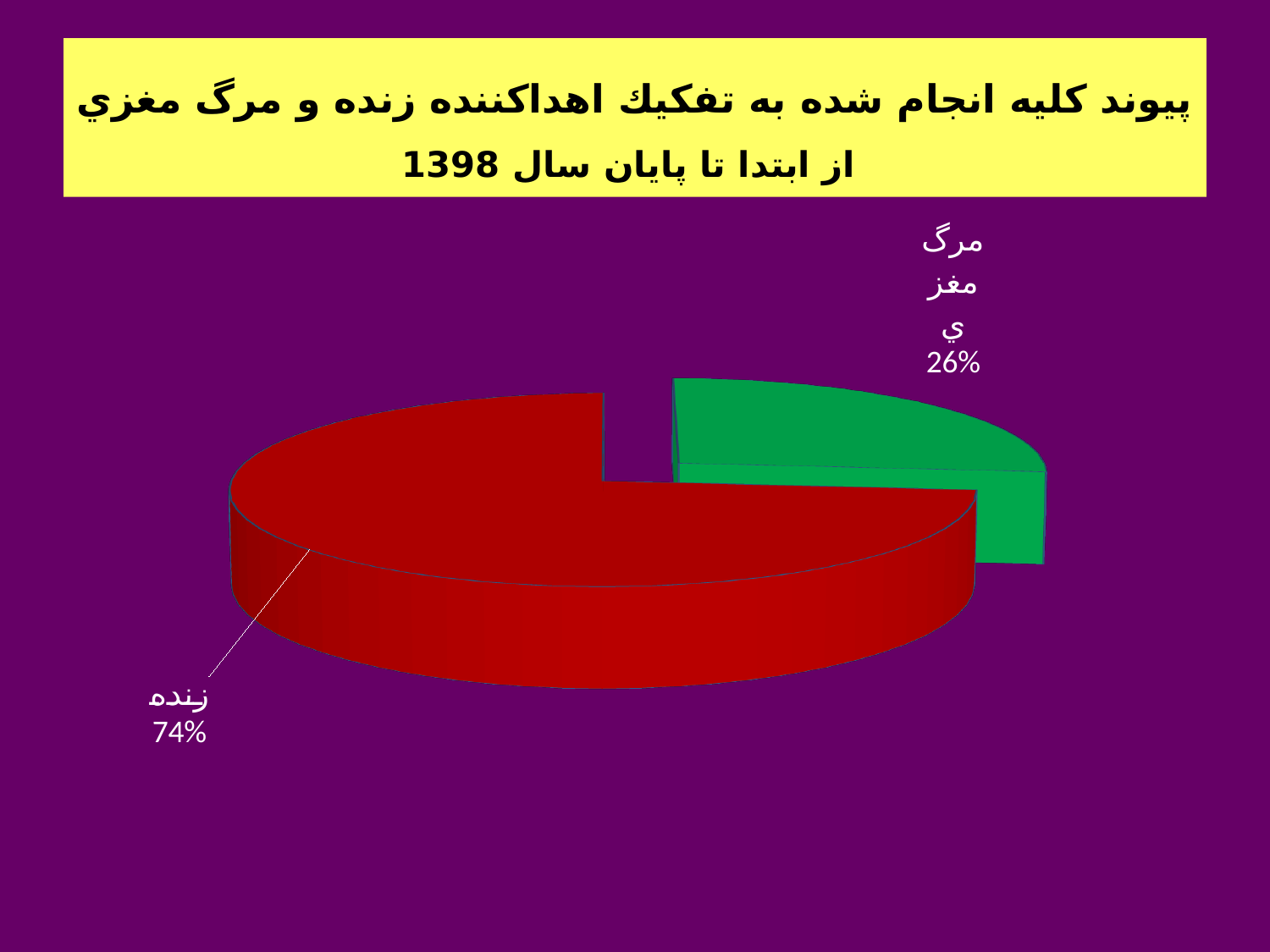
What colour is the زنده slice of the pie? red What is the total of the two percentages shown on the pie chart? 100% Is the share of the مرگ مغزي slice greater or less than 50%? less What colour is the مرگ مغزي slice of the pie? green Which is larger, the زنده slice or the مرگ مغزي slice? زنده What is the difference in percentage points between the زنده slice and the مرگ مغزي slice? 48 What kind of chart is shown on the slide? pie chart What share of the pie does the مرگ مغزي (brain death donor) slice represent? 26% How many slices does the pie chart have? 2 What share of the pie does the زنده (living donor) slice represent? 74% Which slice of the pie is the smallest? مرگ مغزي Which slice of the pie is the largest? زنده